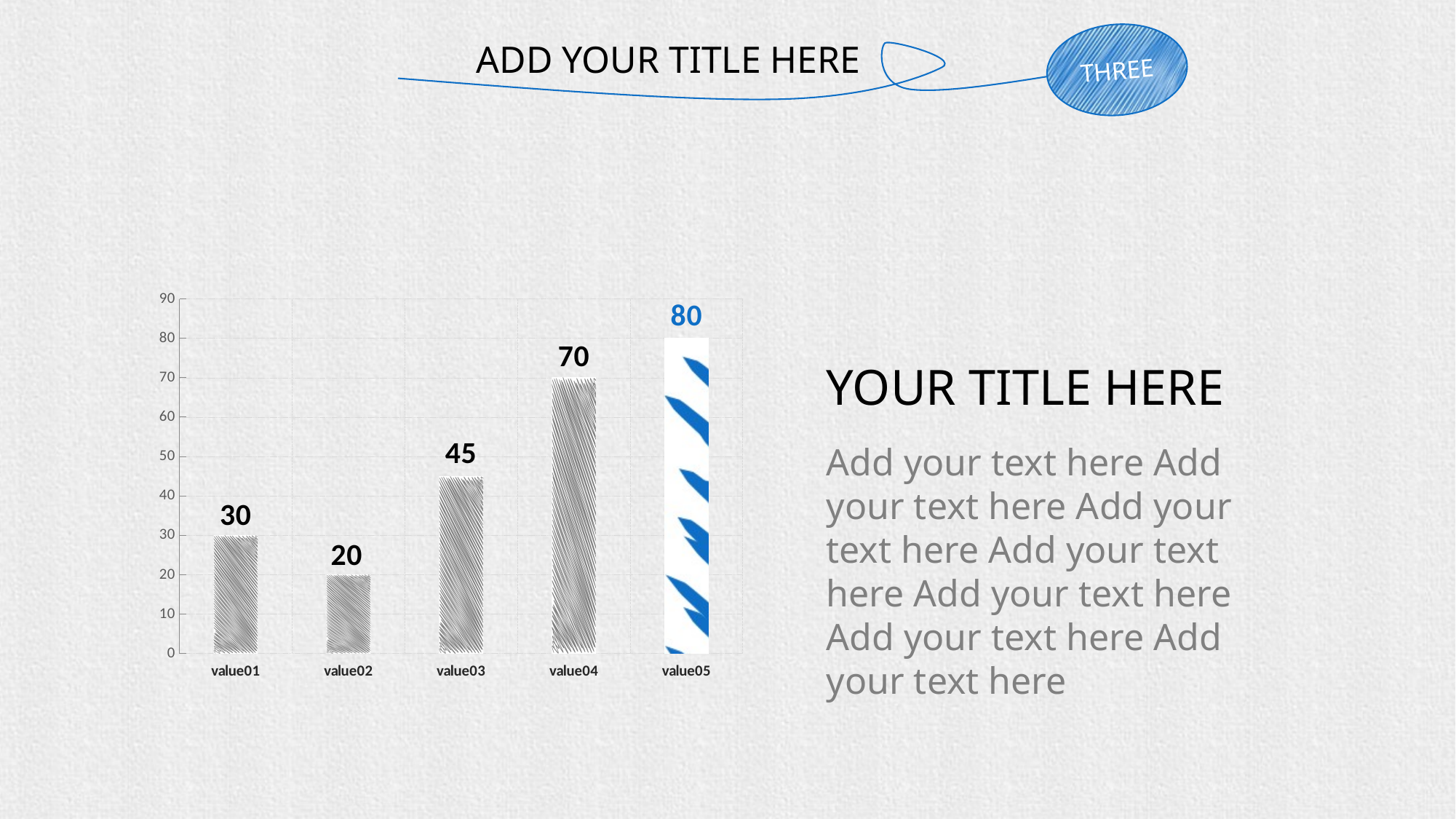
What is the value for value03? 45 Which bar is drawn in blue rather than grey? value05 Is the value for value04 greater or less than 60? greater Which category has the lowest value? value02 What is the value for value05? 80 Which is larger, the value for value01 or the value for value03? value03 What kind of chart is shown on the slide? bar chart Which category has the highest value? value05 What is the difference between the values for value05 and value03? 35 What is the difference between the values for value04 and value02? 50 How many categories are shown on the x axis? 5 What is the value for value01? 30